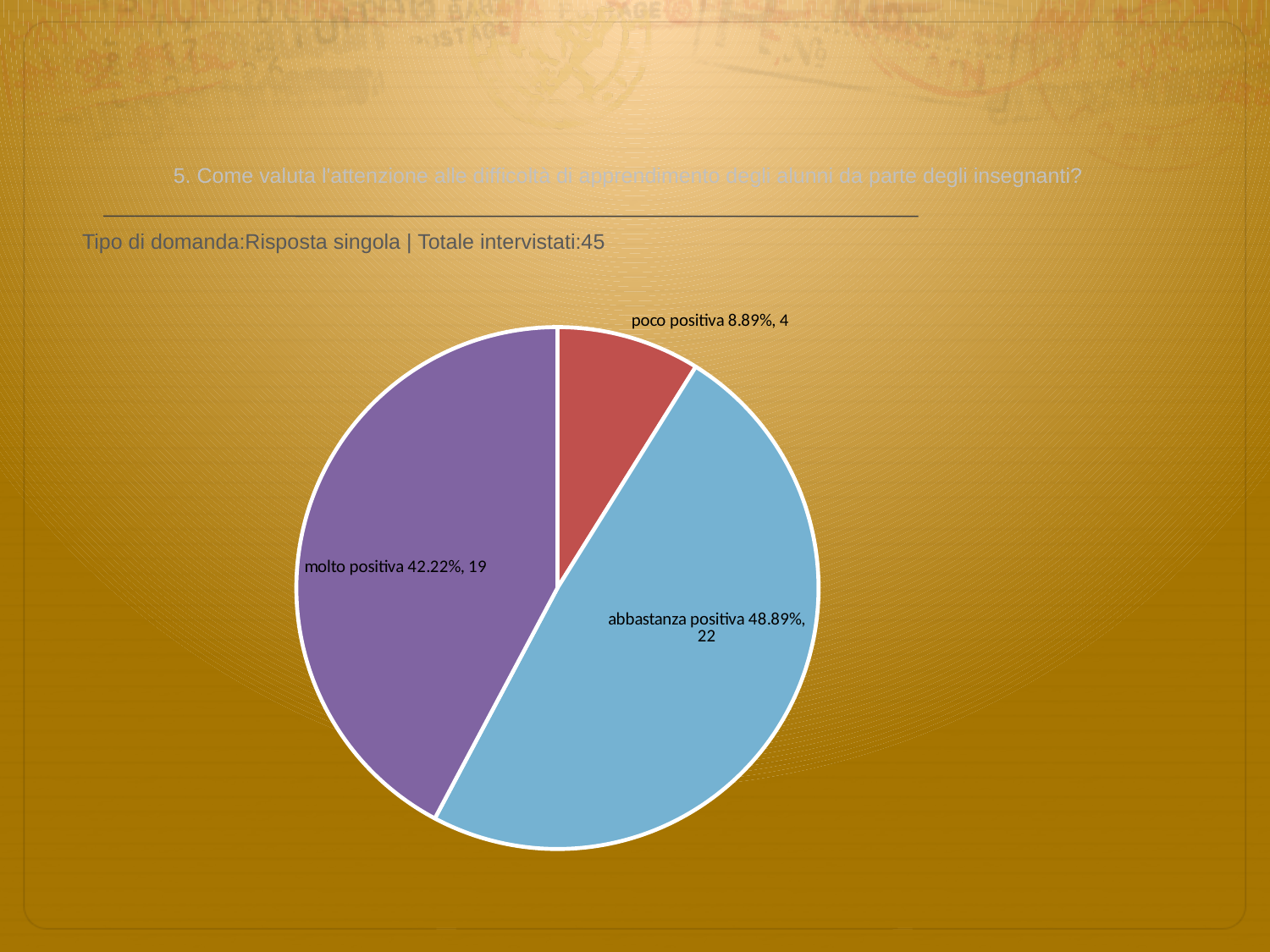
What is the difference in respondent count between 'abbastanza positiva' and 'molto positiva'? 3 How many respondents answered 'abbastanza positiva'? 22 What percentage share does the 'abbastanza positiva' slice have? 48.89% Which category has the smallest slice? poco positiva Which category has the largest slice? abbastanza positiva How many slices does the pie chart have? 3 How many respondents answered 'poco positiva'? 4 What percentage share does the 'molto positiva' slice have? 42.22% What kind of chart is shown on the slide? pie chart What colour is the 'molto positiva' slice? purple How many respondents answered 'molto positiva'? 19 What percentage share does the 'poco positiva' slice have? 8.89%